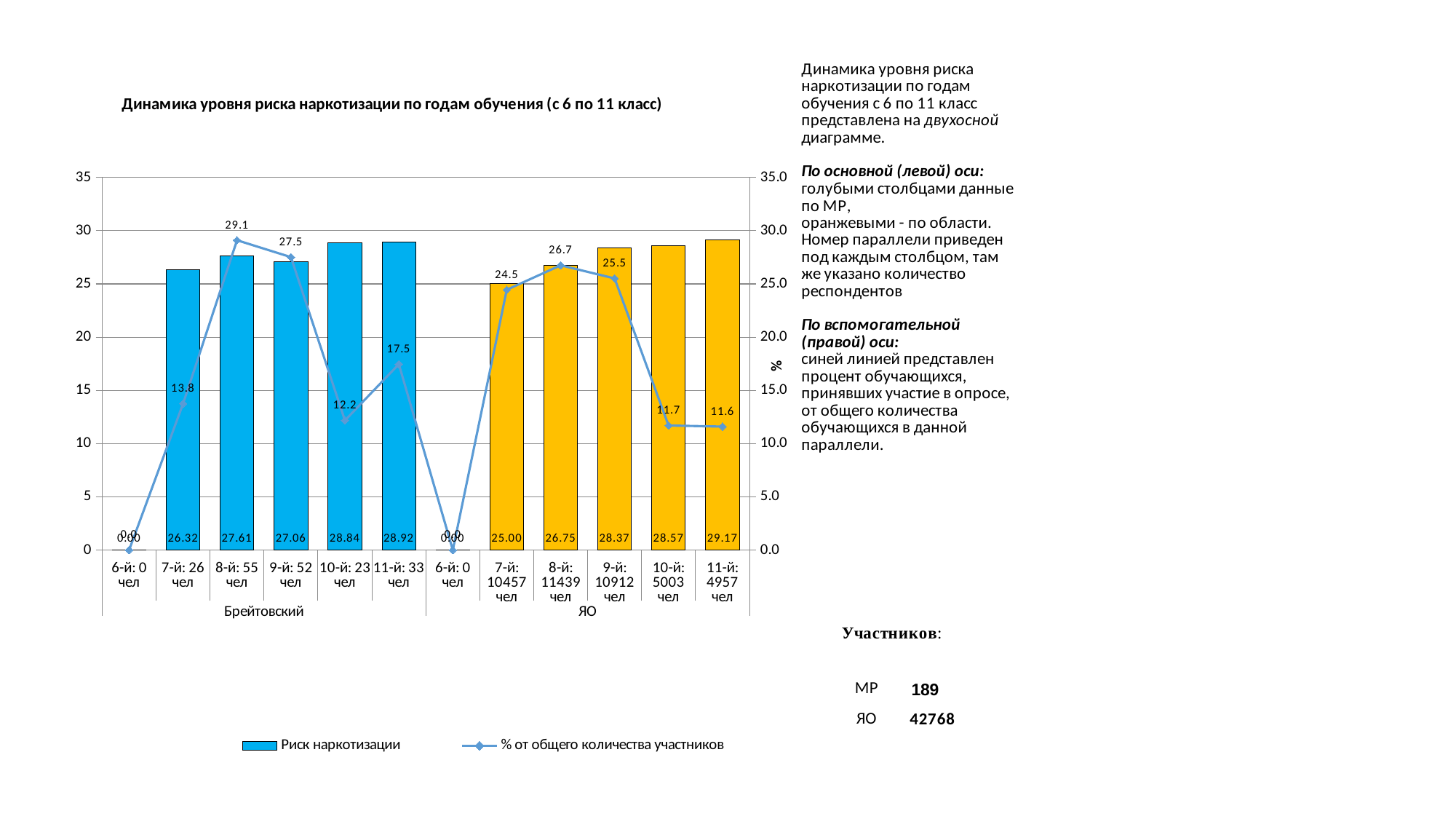
Which class in the ЯО group has the highest 'Риск наркотизации' bar? 11-й Which is larger: the 'Риск наркотизации' value for the 10-й class in Брейтовский or for the 10-й class in ЯО? Брейтовский (28.84) How many categories are shown on the x axis? 12 What is the difference between the 'Риск наркотизации' values for the 11-й and 7-й classes in the ЯО group? 4.17 What is the value of the '% от общего количества участников' line for the 8-й class in the Брейтовский group? 29.1 How many series does the legend list? 2 Which class in the Брейтовский group has the lowest non-zero 'Риск наркотизации' bar? 7-й What kind of chart is shown on the slide? Combined bar and line chart What is the title of the chart? Динамика уровня риска наркотизации по годам обучения (с 6 по 11 класс) What is the value of the '% от общего количества участников' line for the 10-й class in the ЯО group? 11.7 What is the value of the 'Риск наркотизации' bar for the 8-й class in the Брейтовский group? 27.61 What is the value of the 'Риск наркотизации' bar for the 11-й class in the ЯО group? 29.17